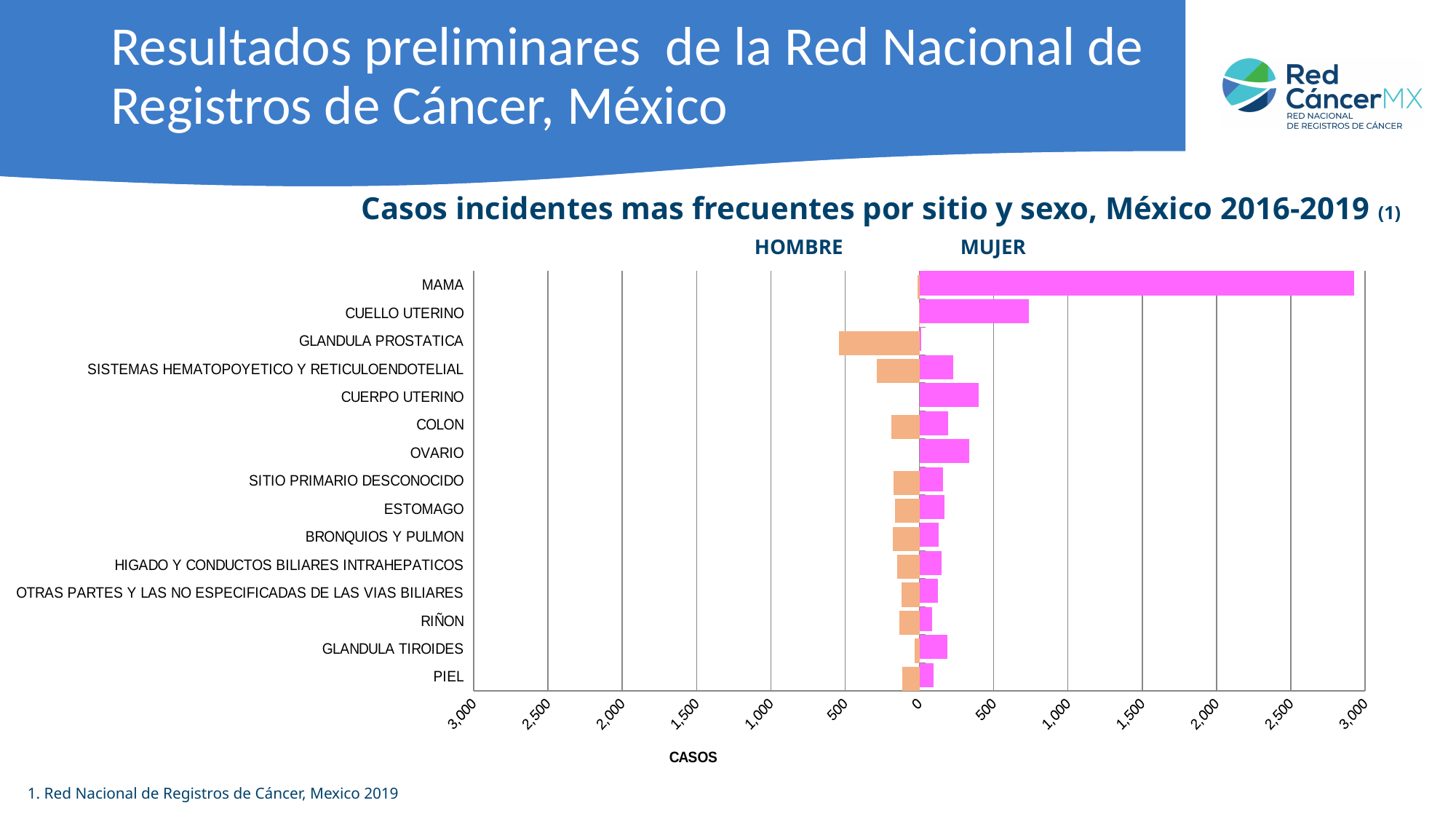
What is the label of the horizontal axis of the chart? CASOS For MUJER, which has more cases: CUELLO UTERINO or CUERPO UTERINO? CUELLO UTERINO How many series (sexes) does the chart show? 2 How many cancer sites (categories) are listed on the chart? 15 Is the MUJER value for MAMA greater or less than 2,500? greater What kind of chart is shown on the slide? bar chart Is the MUJER value for CUELLO UTERINO greater or less than 500? greater Is the HOMBRE value for GLANDULA PROSTATICA greater or less than 1,000? less Which cancer site has the highest number of cases for MUJER? MAMA Which cancer site has the highest number of cases for HOMBRE? GLANDULA PROSTATICA For HOMBRE, which has more cases: GLANDULA PROSTATICA or COLON? GLANDULA PROSTATICA